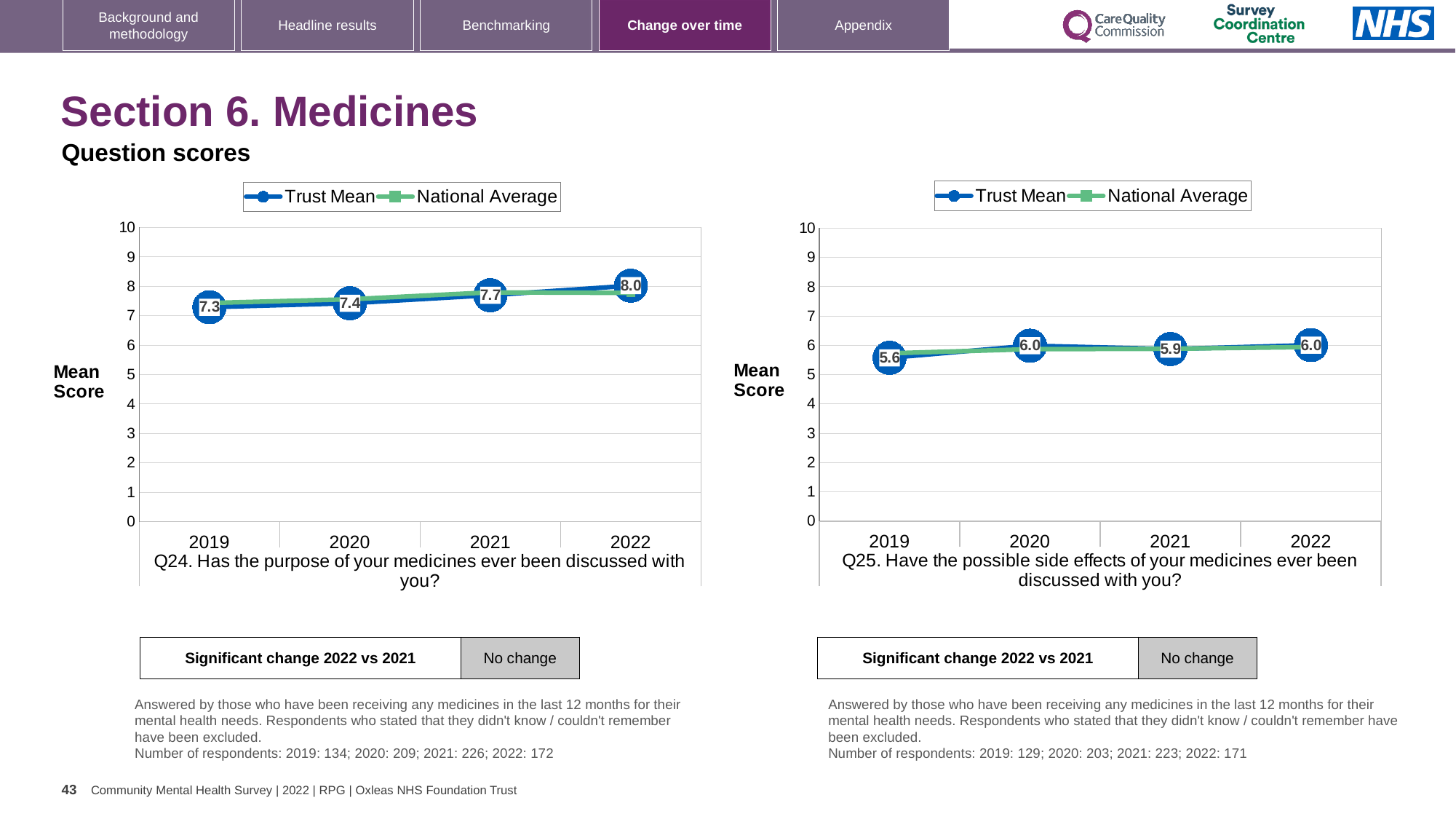
In the Q25 chart (right), what is the Trust Mean for 2021? 5.9 In the Q25 chart (right), what is the Trust Mean for 2019? 5.6 In the Q24 chart (left), what is the difference between the Trust Mean in 2022 and in 2019? 0.7 In the Q24 chart (left), which year has the highest Trust Mean? 2022 In the Q25 chart (right), is the Trust Mean for 2020 greater or less than 5? greater How many series does the legend of the Q24 chart (left) list? 2 In the Q24 chart (left), does the Trust Mean rise or fall from 2019 to 2022? rise In the Q24 chart (left), what is the Trust Mean for 2022? 8.0 In the Q24 chart (left), what is the Trust Mean for 2019? 7.3 What kind of chart is the Q25 chart (right)? line chart In the Q25 chart (right), which year has the lowest Trust Mean? 2019 How many years are plotted on the x axis of the Q25 chart (right)? 4